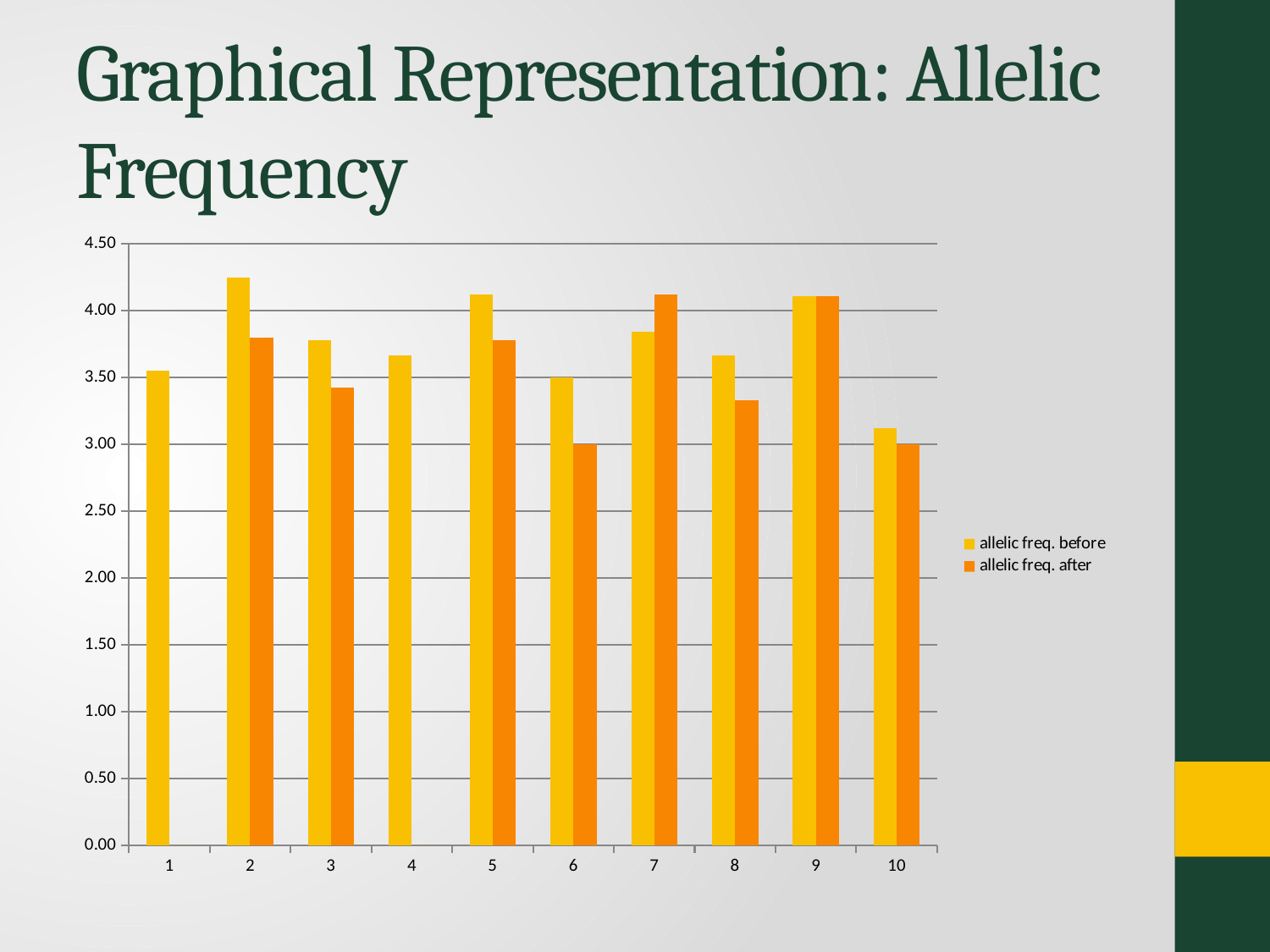
Is the allelic freq. before value for category 2 greater or less than 4.00? greater Is the allelic freq. after value for category 3 greater or less than 3.50? less Is the allelic freq. before value for category 10 greater or less than 3.50? less Which category has the lowest value for allelic freq. before? 10 For category 2, which is larger: allelic freq. before or allelic freq. after? allelic freq. before For category 7, which is larger: allelic freq. before or allelic freq. after? allelic freq. after What kind of chart is shown on the slide? bar chart Which category has the highest value for allelic freq. before? 2 How many series does the legend list? 2 What colour represents the allelic freq. after series? orange How many categories are shown along the x axis? 10